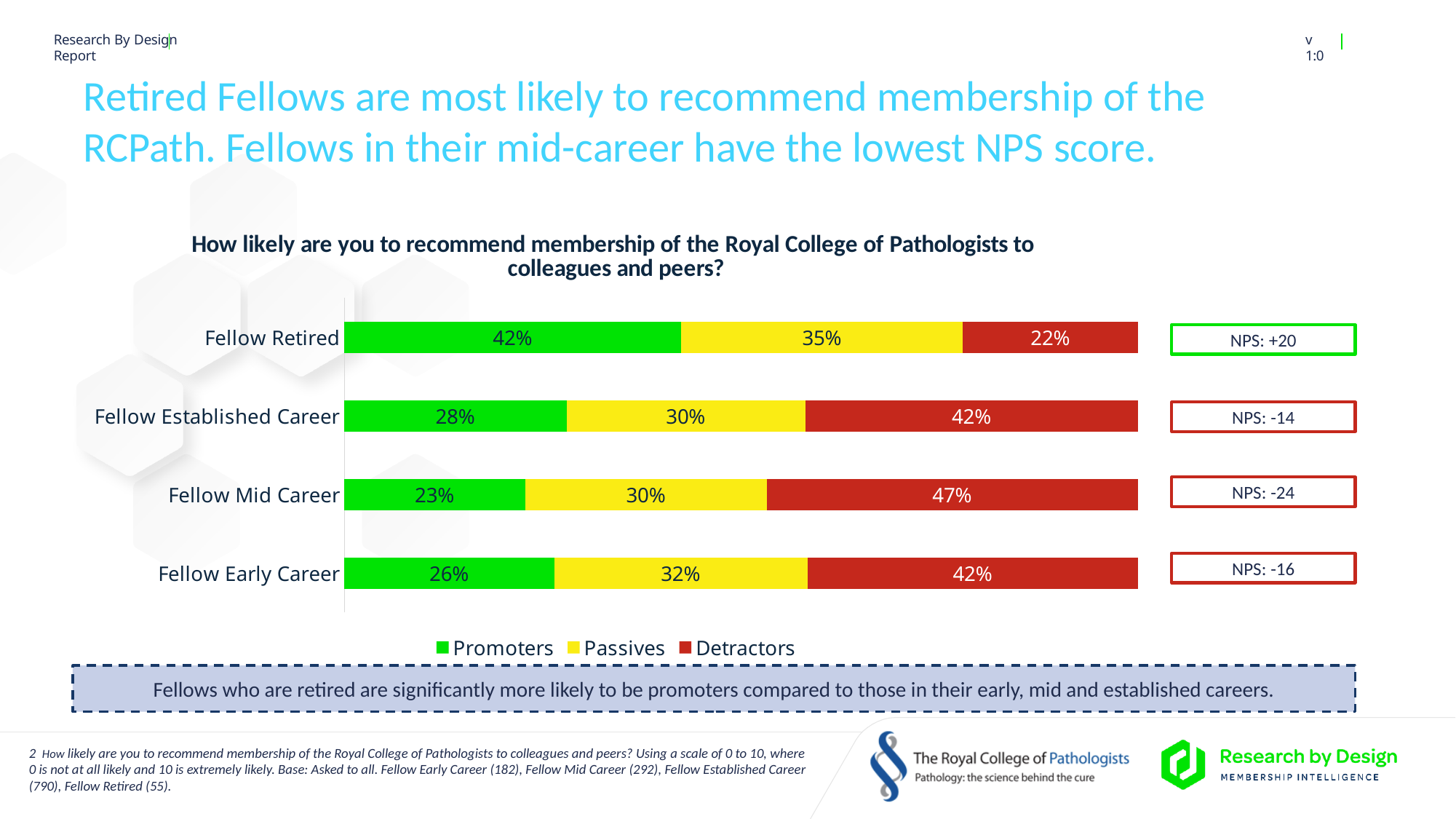
What is the NPS score shown for Fellow Established Career? NPS: -14 What percentage of Fellow Retired respondents are Promoters? 42% How many categories are shown on the chart? 4 What percentage of Fellow Mid Career respondents are Detractors? 47% Which category has the highest share of Promoters? Fellow Retired What percentage of Fellow Early Career respondents are Passives? 32% How many series does the legend list? 3 Which is larger: the Promoters share for Fellow Established Career or for Fellow Early Career? Fellow Established Career Which category has the lowest share of Promoters? Fellow Mid Career Which colour represents Detractors in the chart? Red What kind of chart is shown on the slide? Stacked bar chart What is the difference in Detractors between Fellow Mid Career and Fellow Retired? 25 percentage points